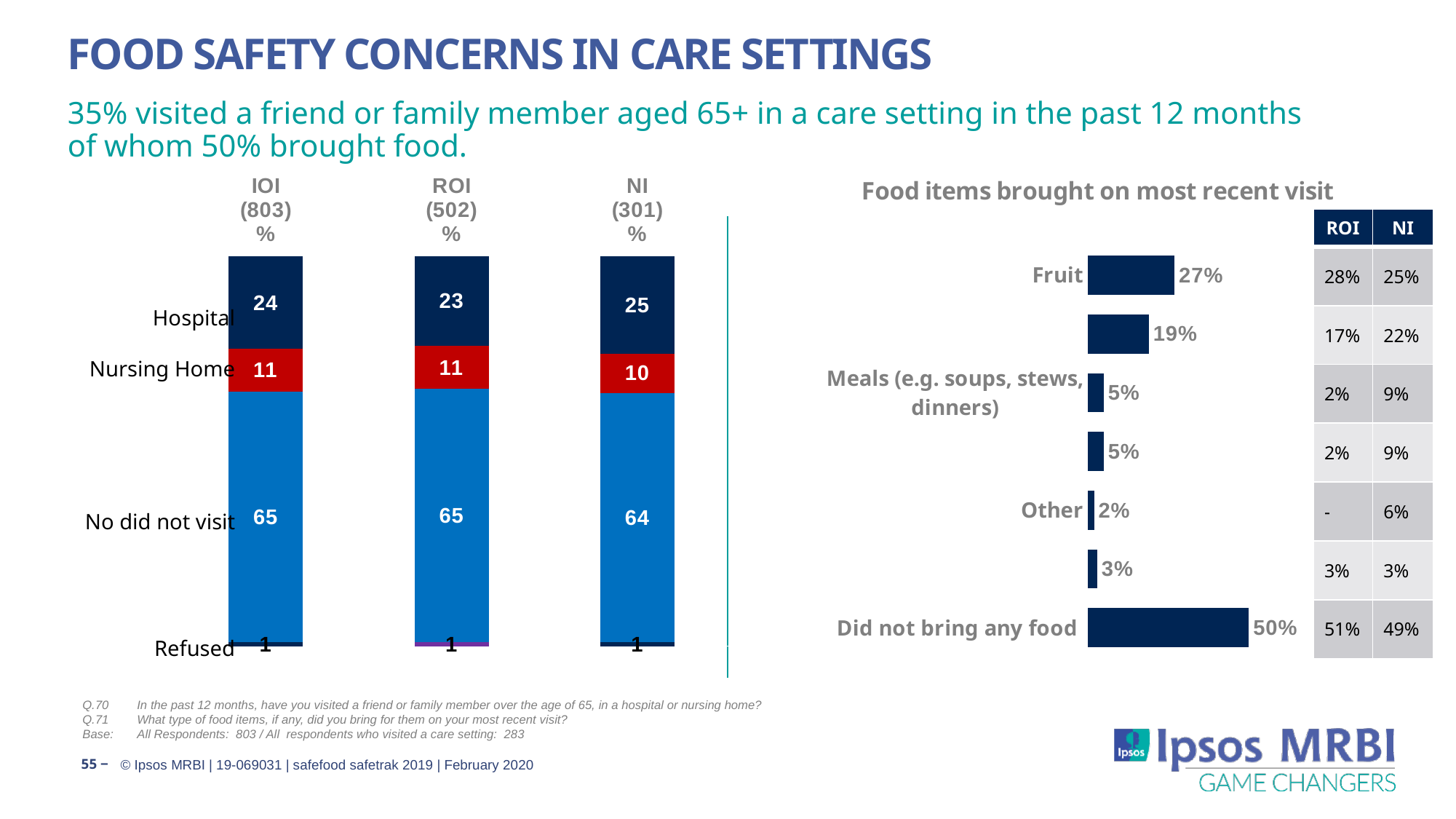
In the 'Food items brought on most recent visit' chart, which labelled category has the lowest value? Other In the left stacked bar chart, what is the Nursing Home value for NI? 10 In the left stacked bar chart, which of the three bars has the highest Hospital value? NI In the 'Food items brought on most recent visit' chart, what is the difference between 'Did not bring any food' and Fruit? 23% In the 'Food items brought on most recent visit' chart, what is the value for Fruit? 27% In the left stacked bar chart, how many bars are shown? 3 In the left stacked bar chart, what is the difference between the Hospital value for NI and the Hospital value for ROI? 2 What type of chart is the 'Food items brought on most recent visit' chart? Bar chart In the left stacked bar chart, what is the total of the IOI bar (Hospital, Nursing Home, No did not visit and Refused)? 101 In the left stacked bar chart, what is the Hospital value for IOI? 24 In the left stacked bar chart, what is the 'No did not visit' value for ROI? 65 In the 'Food items brought on most recent visit' chart, what is the value for 'Did not bring any food'? 50%